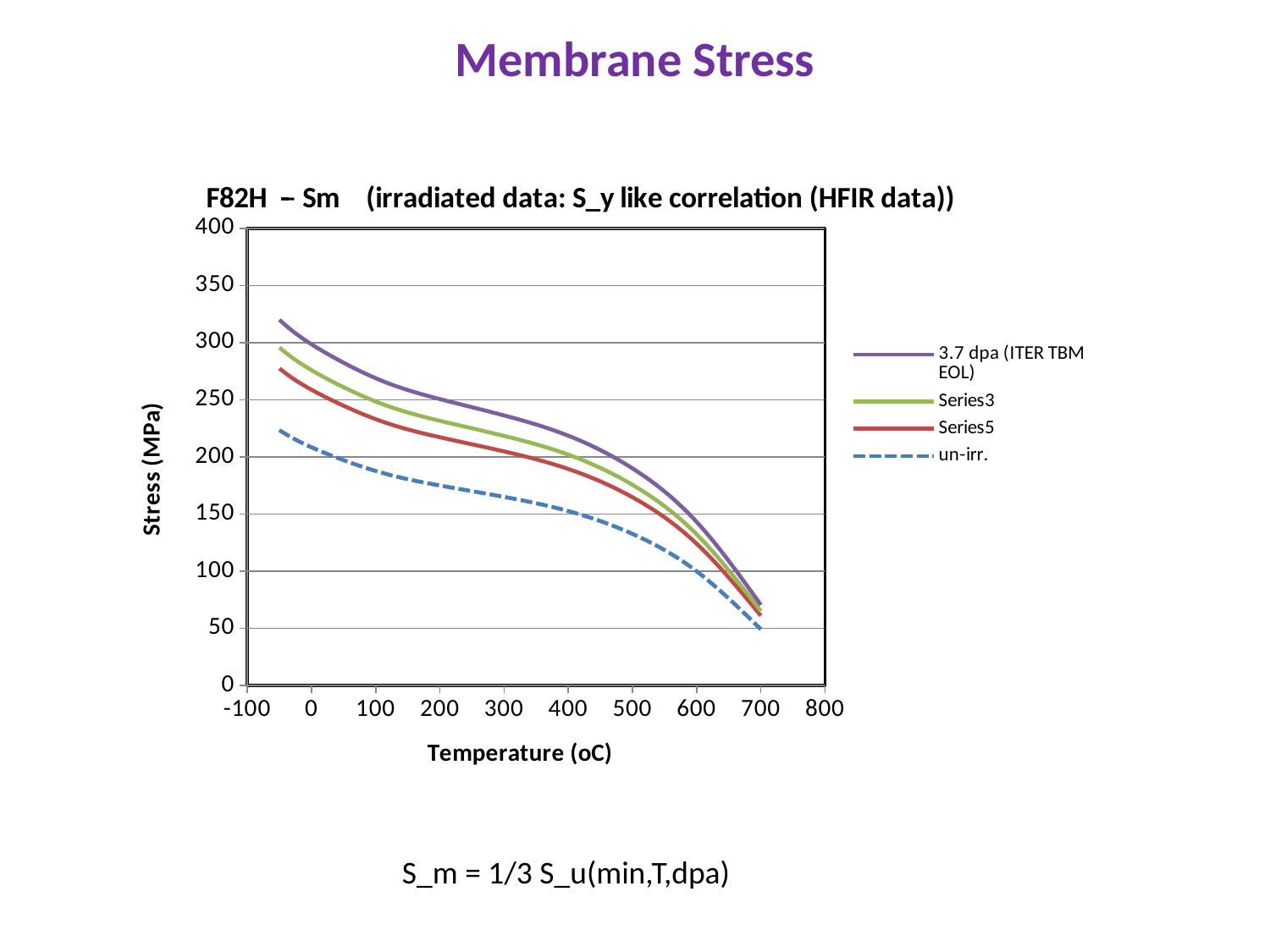
What is the label of the y axis? Stress (MPa) Do the stress values rise or fall as temperature increases along the x axis? fall Is the value for un-irr. at 200 °C greater or less than 200? less How many series does the legend list? 4 At 300 °C, which is larger: the value for 3.7 dpa (ITER TBM EOL) or the value for un-irr.? 3.7 dpa (ITER TBM EOL) Is the value for Series3 at 300 °C greater or less than 200? greater Which series has the highest stress at 100 °C? 3.7 dpa (ITER TBM EOL) What kind of chart is shown on the slide? line chart Which series has the lowest stress at 300 °C? un-irr. Is the value for Series5 at 400 °C greater or less than 200? less What is the title of the chart? F82H – Sm (irradiated data: S_y like correlation (HFIR data))